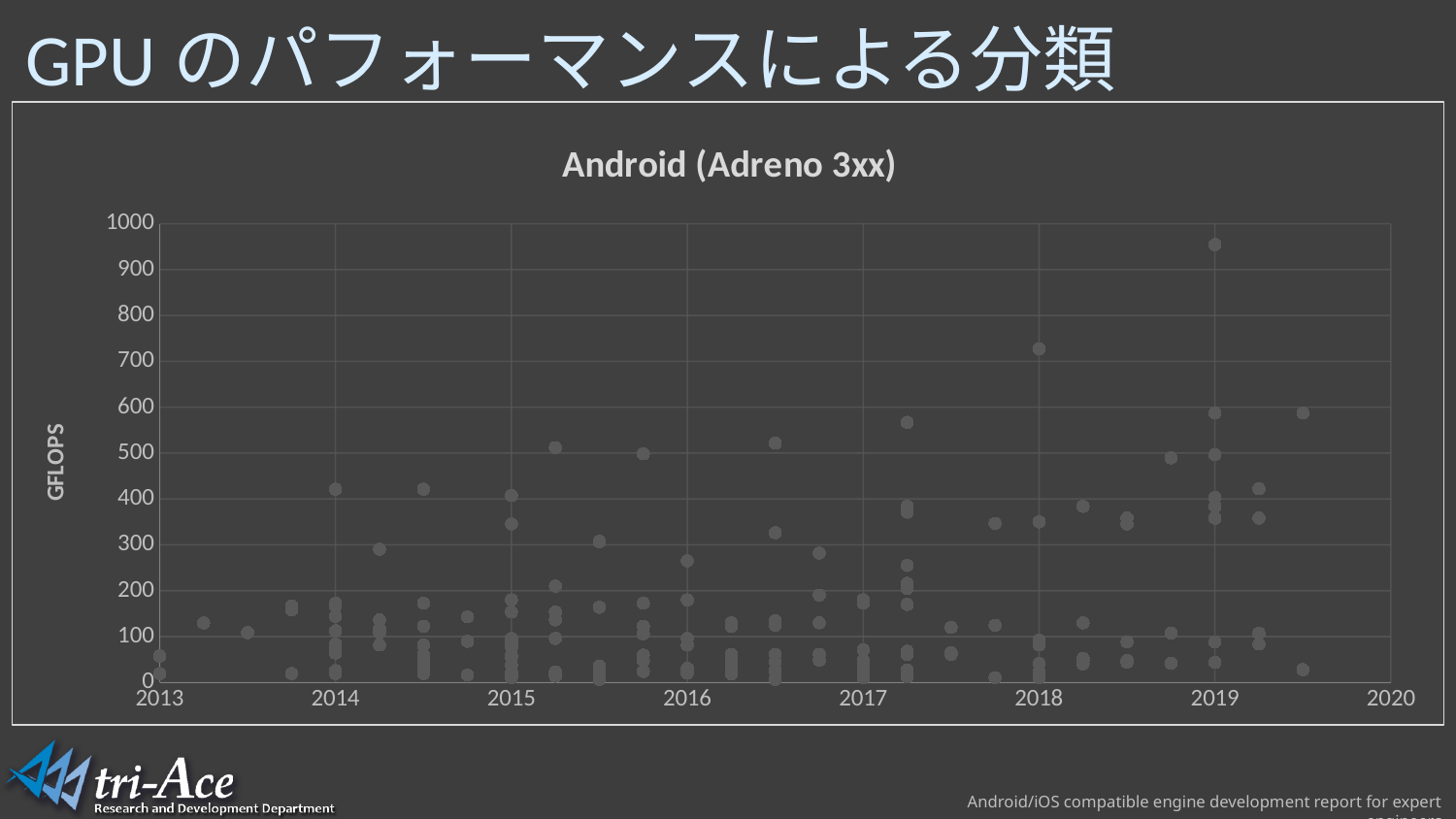
Is the highest point plotted near 2018 greater or less than 700 GFLOPS? greater What is the maximum value shown on the vertical axis? 1000 What is the title of the chart? Android (Adreno 3xx) Are the points plotted at 2013 greater or less than 100 GFLOPS? less Do the highest GFLOPS values generally rise or fall from 2013 to 2019? rise In which year does the highest plotted point on the chart appear? 2019 What kind of chart is shown on the slide? scatter chart Is the highest point plotted near 2016 greater or less than 600 GFLOPS? less What is the label of the vertical axis? GFLOPS